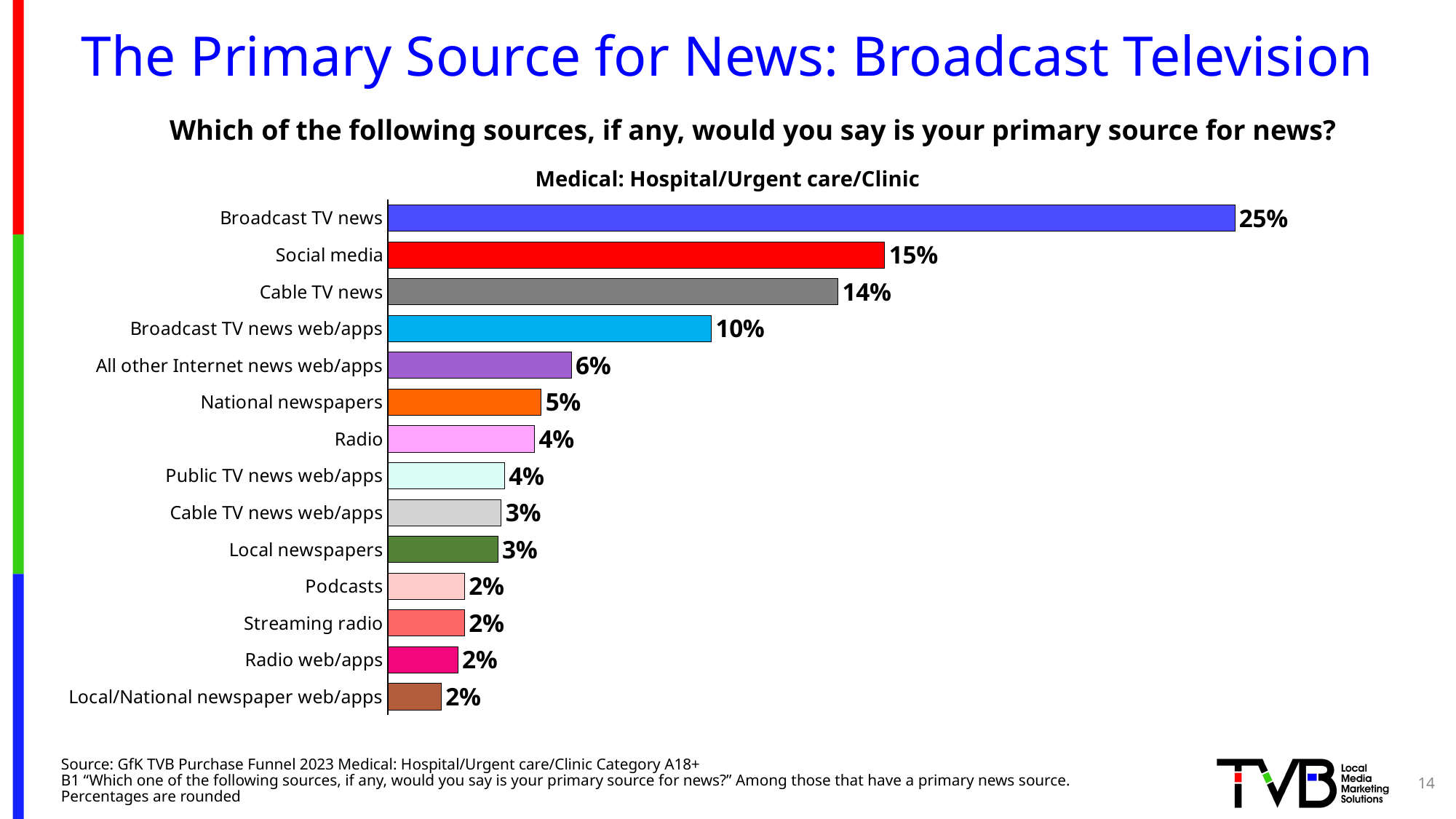
What is the difference in percentage points between Broadcast TV news and Cable TV news? 11 Which is larger, Social media or Cable TV news? Social media How many news source categories are shown in the chart? 14 What is the difference between Social media and Broadcast TV news web/apps? 5 What is the title of the chart? Medical: Hospital/Urgent care/Clinic Which news source has the highest percentage in the chart? Broadcast TV news What is the value shown for Social media? 15% What is the value for National newspapers? 5% Which is larger, Cable TV news or All other Internet news web/apps? Cable TV news What percentage is shown for Broadcast TV news web/apps? 10% What type of chart is shown on the slide? Bar chart What percentage of respondents named Broadcast TV news as their primary source for news? 25%